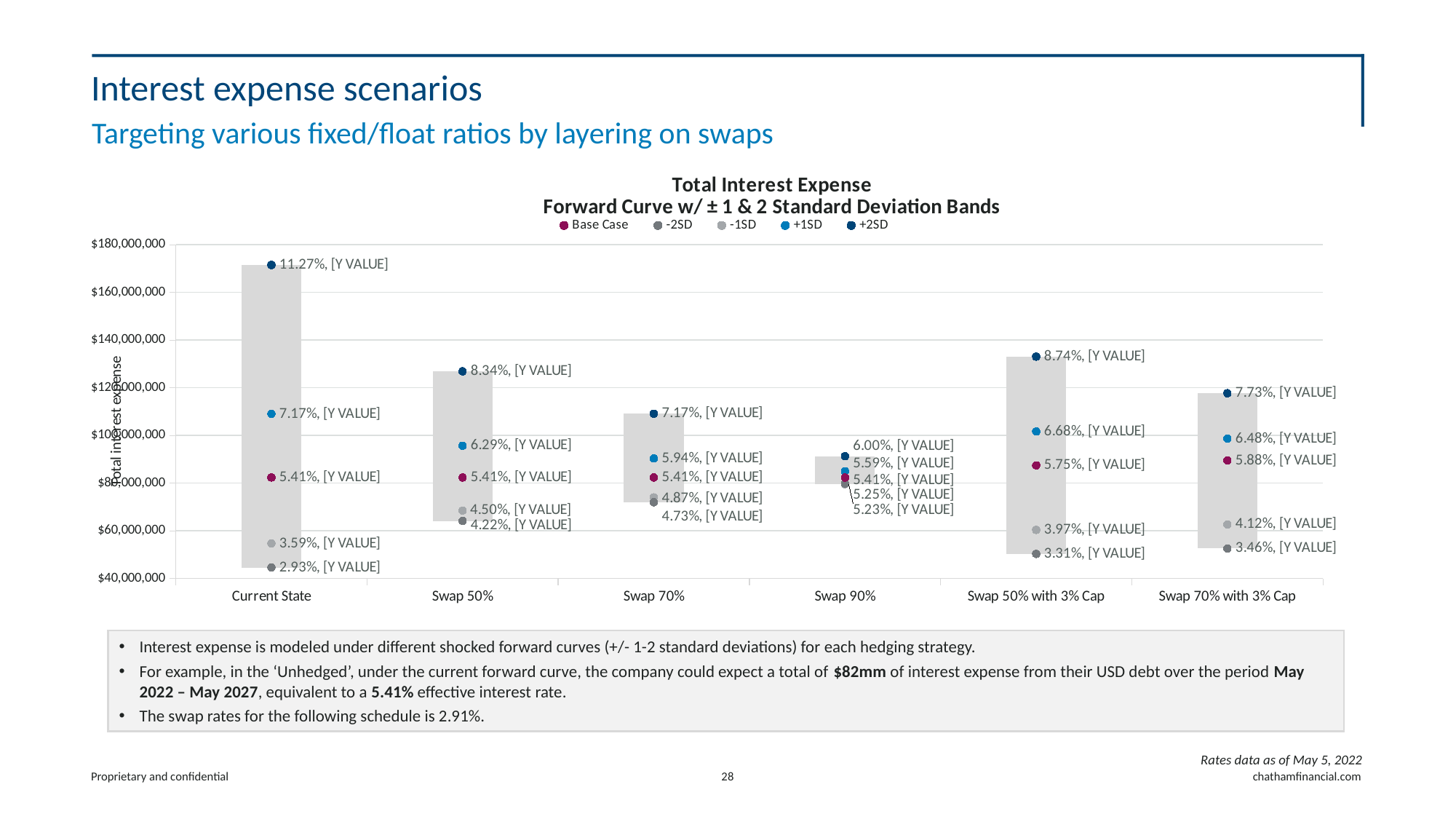
What rate label is shown for the +1SD point in the Swap 70% with 3% Cap scenario? 6.48% Is the -2SD value for Current State greater or less than $60,000,000? less Which scenario has the highest +2SD total interest expense? Current State Is the +2SD value for Current State greater or less than $160,000,000? greater What rate label is shown for the -1SD point in the Swap 50% scenario? 4.50% What rate label is shown for the +2SD point in the Current State scenario? 11.27% Is the +2SD value for Swap 50% with 3% Cap greater or less than $120,000,000? greater What rate label is shown for the Base Case point in the Swap 70% scenario? 5.41% Which is larger, the +2SD value for Current State or the +2SD value for Swap 90%? Current State How many scenarios are shown on the x axis? 6 What rate label is shown for the -2SD point in the Swap 50% with 3% Cap scenario? 3.31% How many series does the legend list? 5